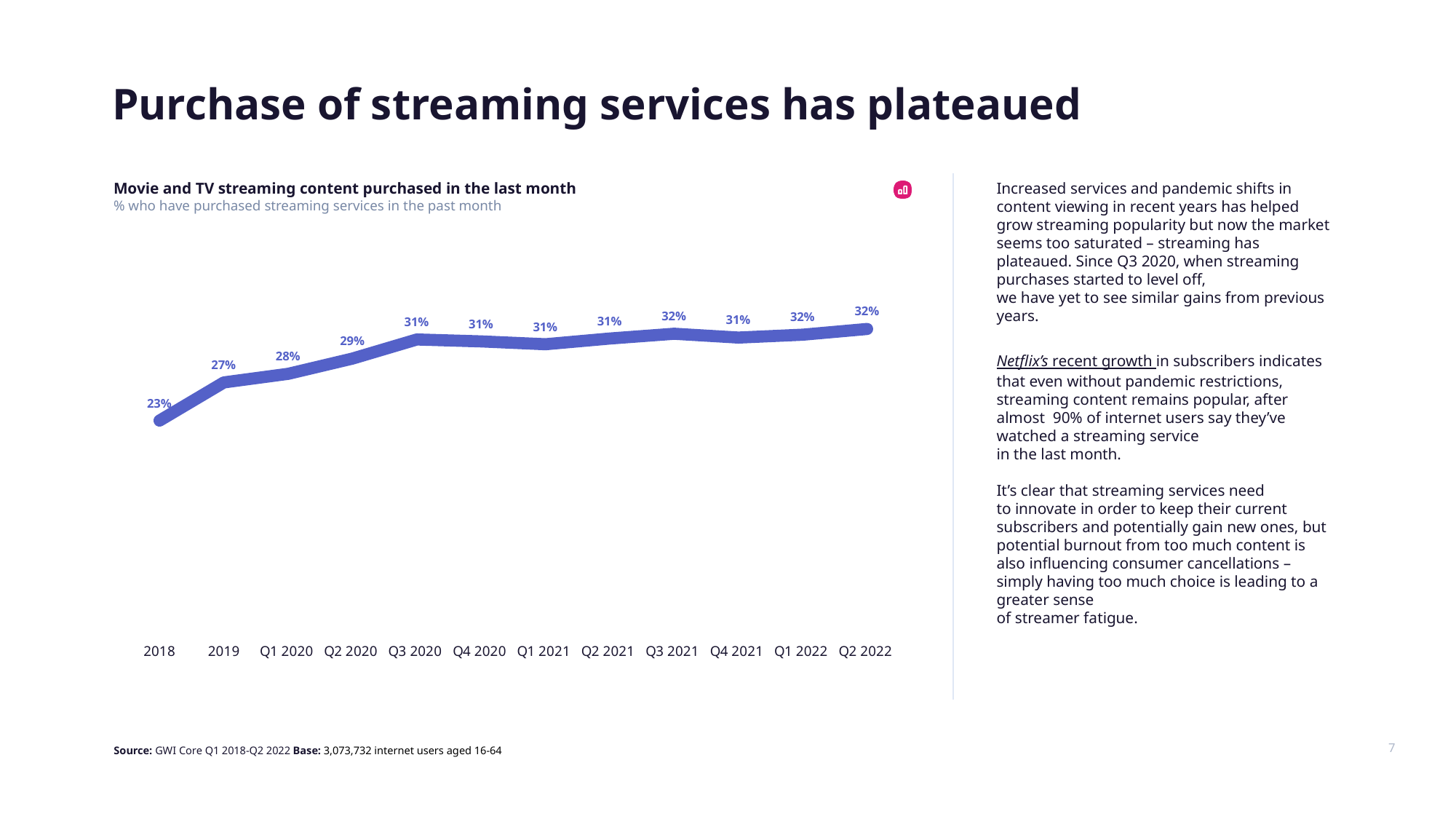
What is the value shown for Q2 2022? 32% What is the difference between the values for Q2 2022 and 2018? 9 percentage points Which is larger, the value for 2019 or the value for Q3 2021? Q3 2021 What is the value shown for Q3 2020? 31% What is the difference between the values for Q2 2020 and 2019? 2 percentage points Do the values generally rise or fall from 2018 to Q2 2022? Rise How many time periods are plotted on the chart? 12 What kind of chart is shown on the slide? Line chart What percentage of internet users purchased streaming services in the past month in 2018? 23% What is the title of the chart? Movie and TV streaming content purchased in the last month What is the value shown for 2019? 27% Which period has the lowest value on the chart? 2018